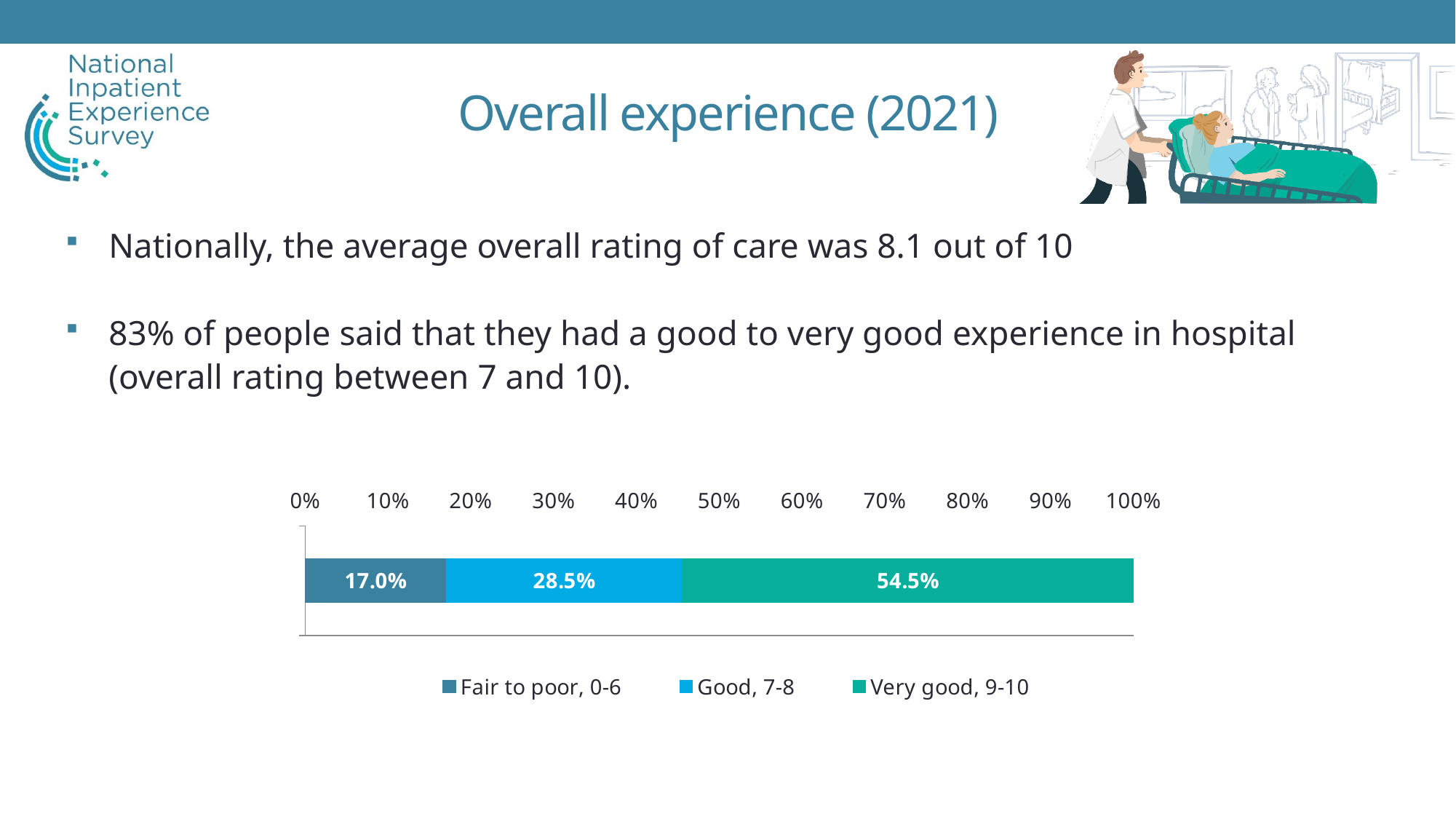
What is the difference in percentage points between 'Very good, 9-10' and 'Good, 7-8'? 26.0 What percentage of respondents rated their experience as 'Very good, 9-10'? 54.5% What is the difference in percentage points between 'Good, 7-8' and 'Fair to poor, 0-6'? 11.5 What percentage of respondents rated their experience as 'Fair to poor, 0-6'? 17.0% Which rating category has the largest share of respondents? Very good, 9-10 What percentage of respondents rated their experience as 'Good, 7-8'? 28.5% Which rating category has the smallest share of respondents? Fair to poor, 0-6 What is the combined total of the 'Good, 7-8' and 'Very good, 9-10' segments? 83.0% What kind of chart is shown on the slide? Stacked bar chart How many series does the legend list? 3 Which is larger: the share for 'Good, 7-8' or the share for 'Fair to poor, 0-6'? Good, 7-8 Is the value for 'Very good, 9-10' greater or less than 50%? greater